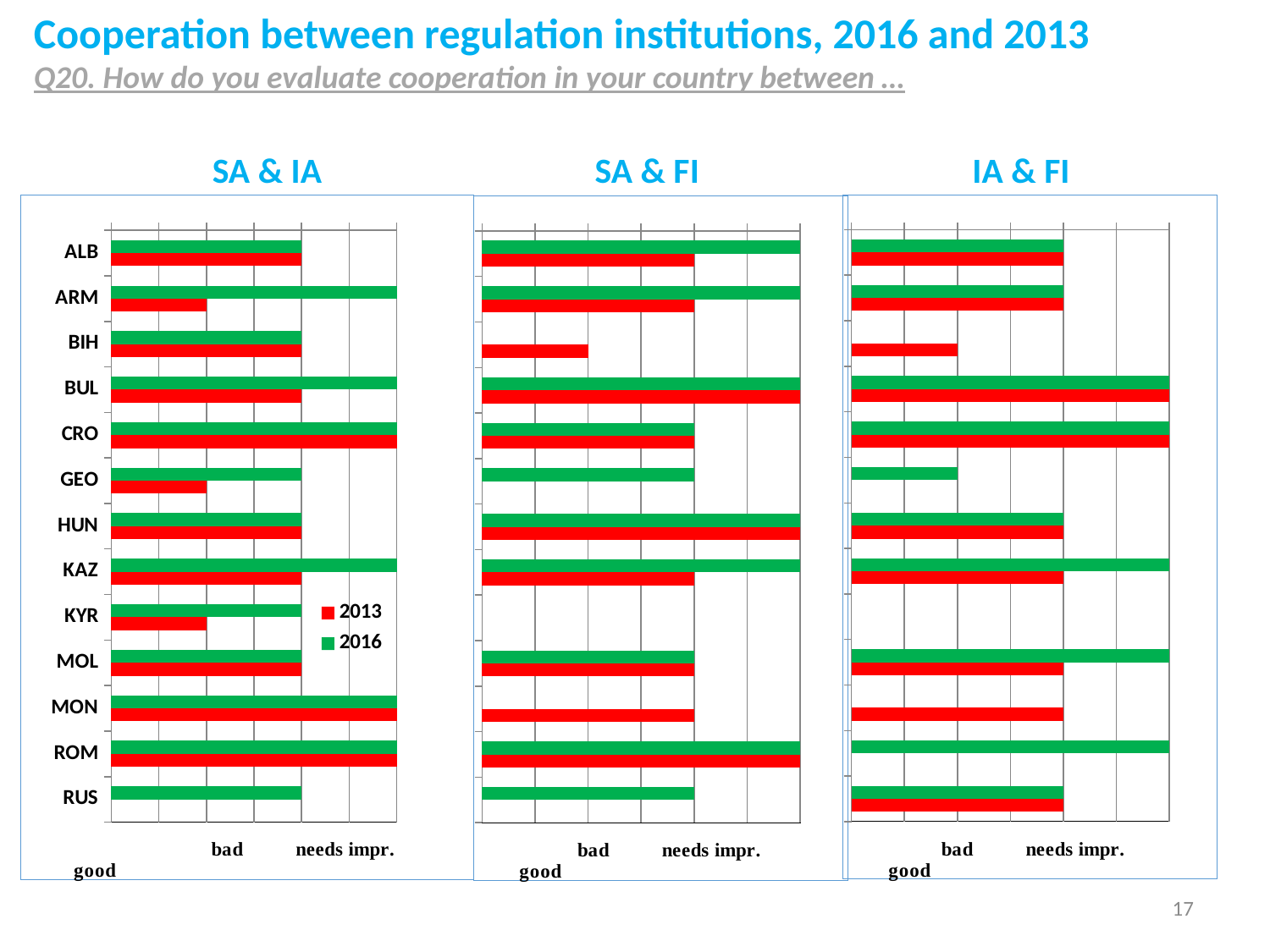
How many series does the legend on the SA & IA chart list? 2 Which colour represents 2013 in the legend of the SA & IA chart? red How many countries are listed on the vertical axis of the SA & IA chart? 13 What kind of chart is the SA & IA chart? bar chart In the SA & IA chart, which year's bar for ARM is longer, 2013 or 2016? 2016 In the IA & FI chart, which year's bar for KAZ is longer, 2013 or 2016? 2016 In the SA & FI chart, which year's bar for ALB is longer, 2013 or 2016? 2016 What is the title of the chart on the right of the slide? IA & FI